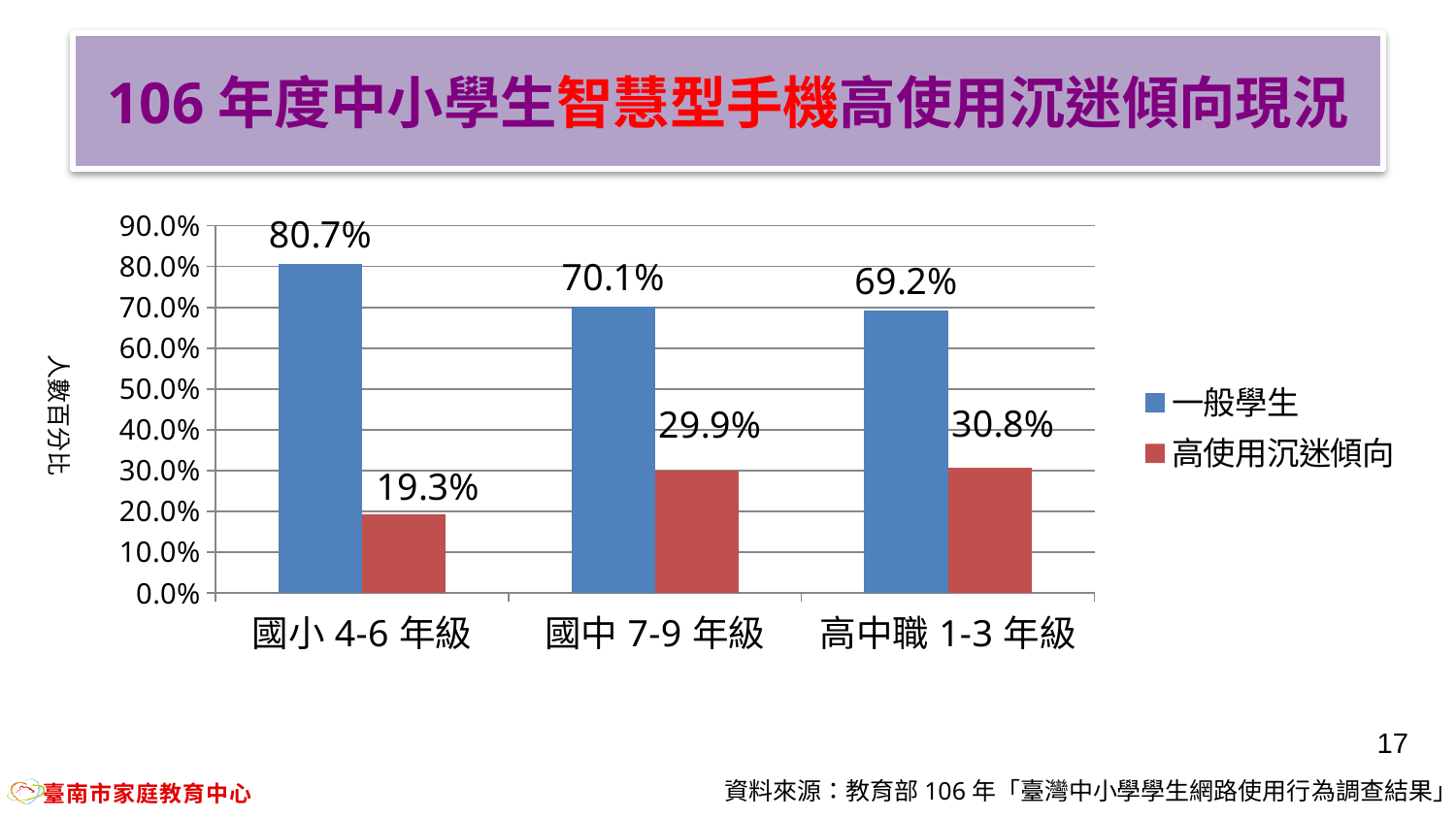
What is the value for 一般學生 in the 國小 4-6 年級 category? 80.7% What is the difference between the 一般學生 and 高使用沉迷傾向 values in the 國小 4-6 年級 category? 61.4% Which is larger: the 一般學生 value for 國中 7-9 年級 or for 高中職 1-3 年級? 國中 7-9 年級 How many categories are shown on the x axis? 3 Do the 高使用沉迷傾向 values rise or fall from 國小 4-6 年級 to 高中職 1-3 年級? Rise Which category has the highest value for 一般學生? 國小 4-6 年級 What is the value for 高使用沉迷傾向 in the 國中 7-9 年級 category? 29.9% How many series does the legend list? 2 What is the value for 高使用沉迷傾向 in the 高中職 1-3 年級 category? 30.8% Which category has the lowest value for 高使用沉迷傾向? 國小 4-6 年級 What kind of chart is shown on the slide? Bar chart What is the label of the y axis? 人數百分比